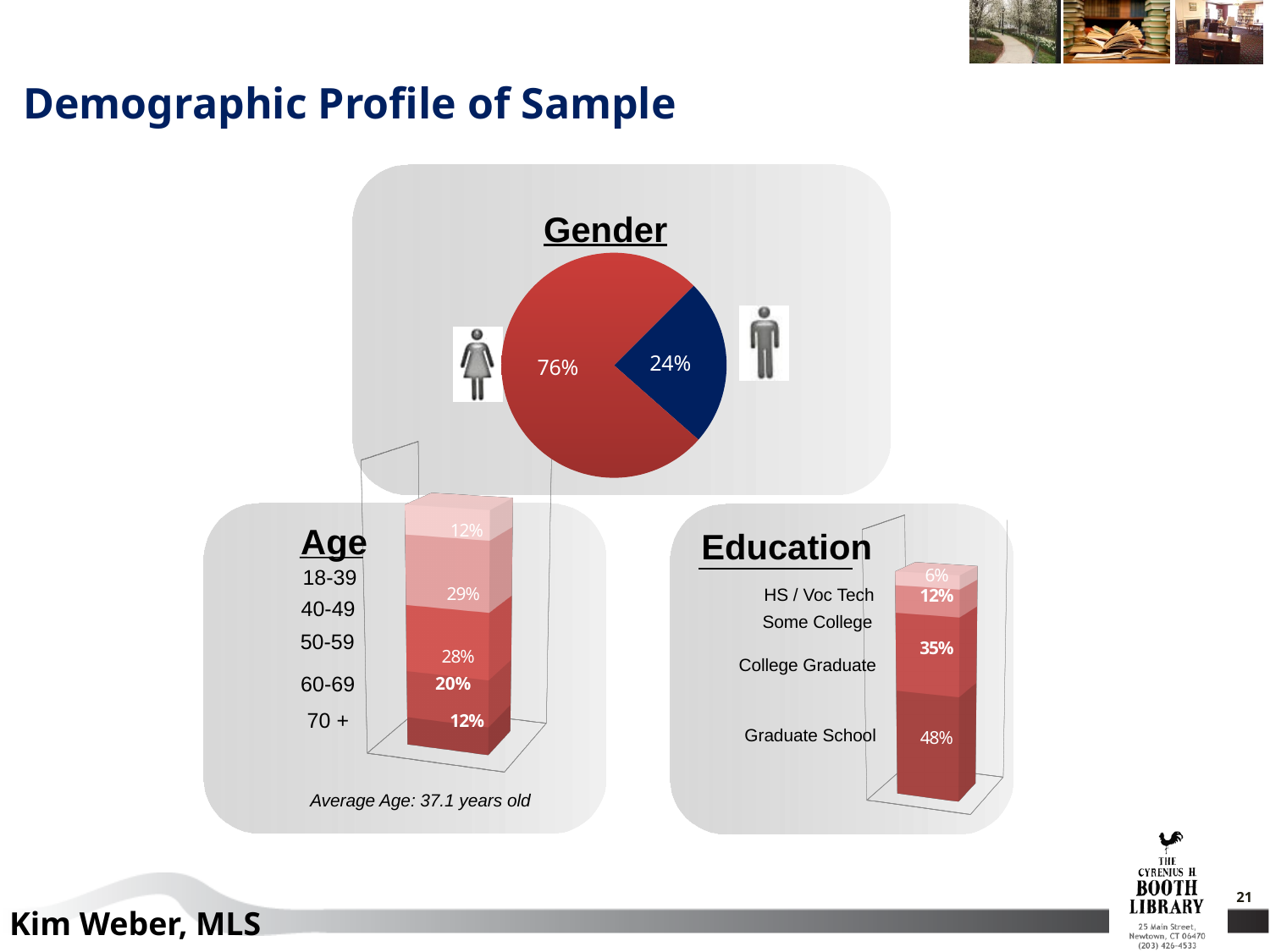
What average age is stated below the Age chart? 37.1 years old On the Gender pie chart, what percentage of the sample is male? 24% On the Education chart, which category has the highest percentage? Graduate School What kind of chart is used for Education? Stacked bar chart On the Education chart, what percentage of the sample attended Graduate School? 48% On the Education chart, what is the difference between the Graduate School and College Graduate percentages? 13% On the Gender pie chart, what percentage of the sample is female? 76% On the Education chart, what percentage of the sample are College Graduates? 35% How many age categories are listed on the Age chart? 5 What kind of chart is used for Gender? Pie chart On the Gender pie chart, which group is larger, female or male? Female On the Gender pie chart, what is the difference in percentage points between the female and male shares? 52%